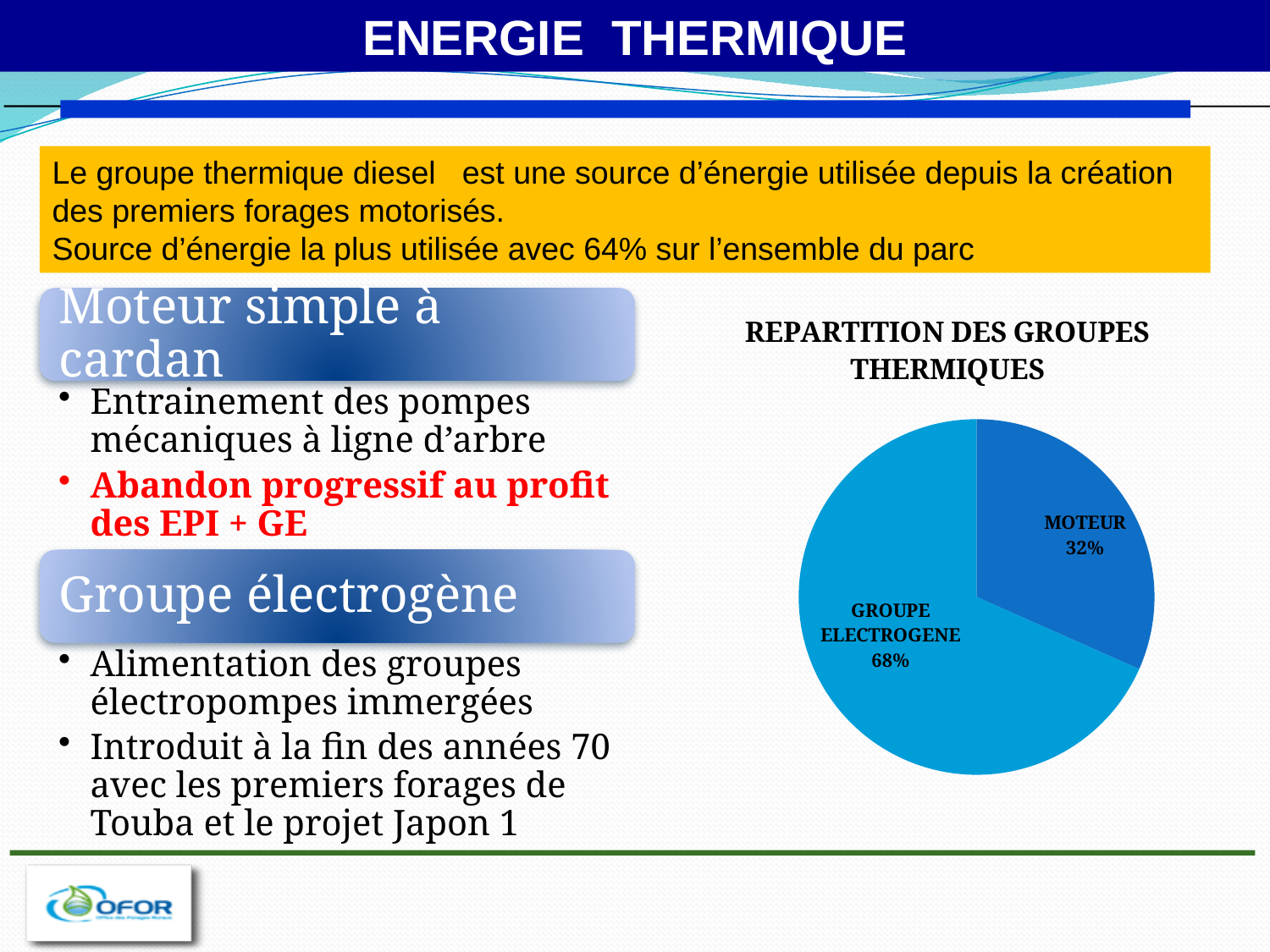
How many slices does the pie chart have? 2 What share of the pie does MOTEUR represent? 32% What kind of chart is shown on the slide? pie chart What is the title of the chart? REPARTITION DES GROUPES THERMIQUES Which is larger, the share for MOTEUR or the share for GROUPE ELECTROGENE? GROUPE ELECTROGENE What is the total of the two slices shown in the pie chart? 100% Is the share for MOTEUR greater or less than 50%? less Which category has the smallest share of the pie? MOTEUR What is the difference in percentage points between the GROUPE ELECTROGENE share and the MOTEUR share? 36 Which category has the largest share of the pie? GROUPE ELECTROGENE What share of the pie does GROUPE ELECTROGENE represent? 68%